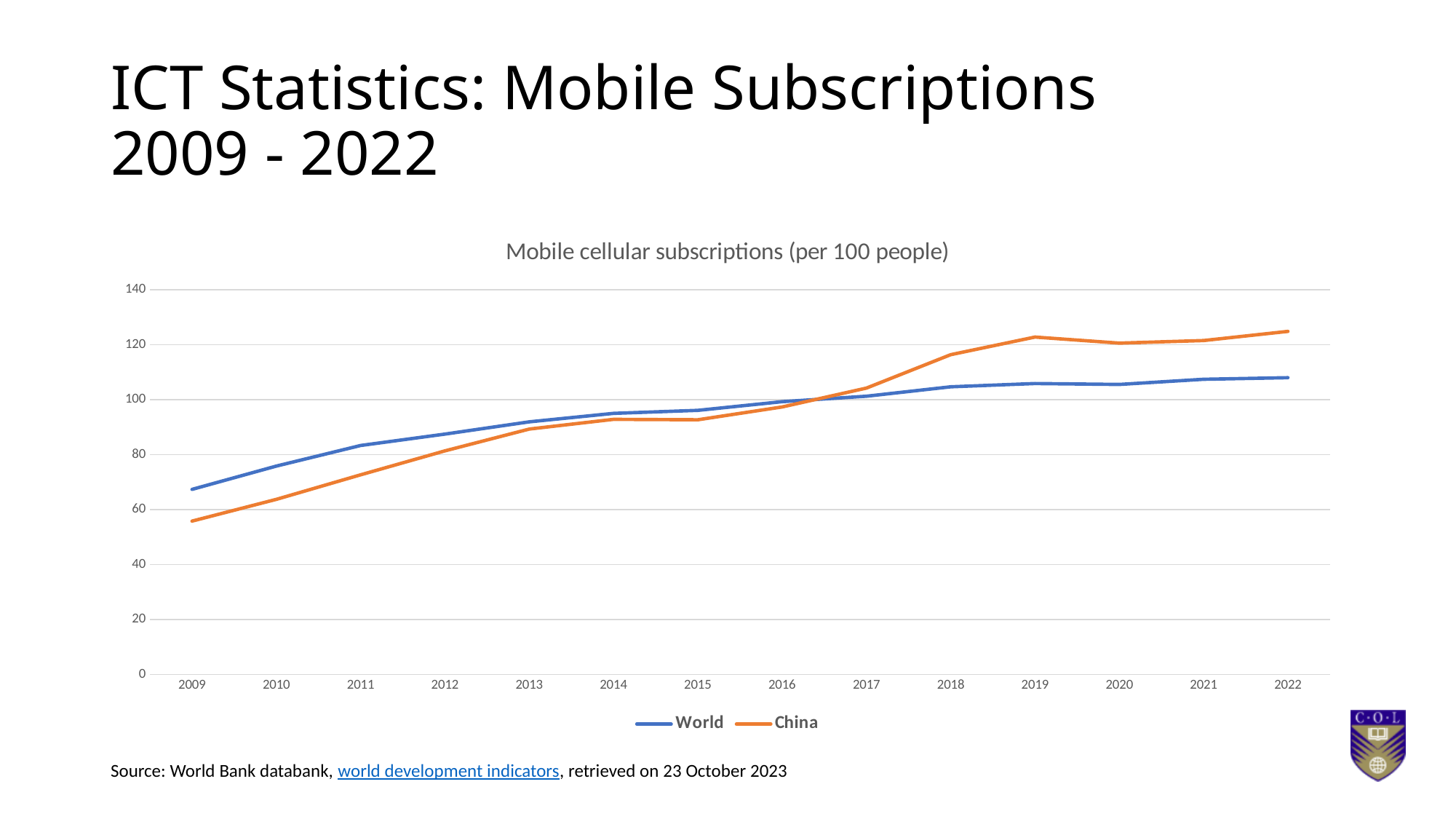
What is the title of the chart? Mobile cellular subscriptions (per 100 people) Is the value for China in 2022 greater or less than 120? greater In 2009, which series has the higher value, World or China? World Is the value for World in 2022 greater or less than 120? less In which year is the China series at its lowest? 2009 How many years are plotted along the x axis? 14 How many series does the legend list? 2 Is the value for World in 2009 greater or less than 60? greater Which series is drawn in orange? China What kind of chart is shown on the slide? line chart In 2022, which series has the higher value, World or China? China